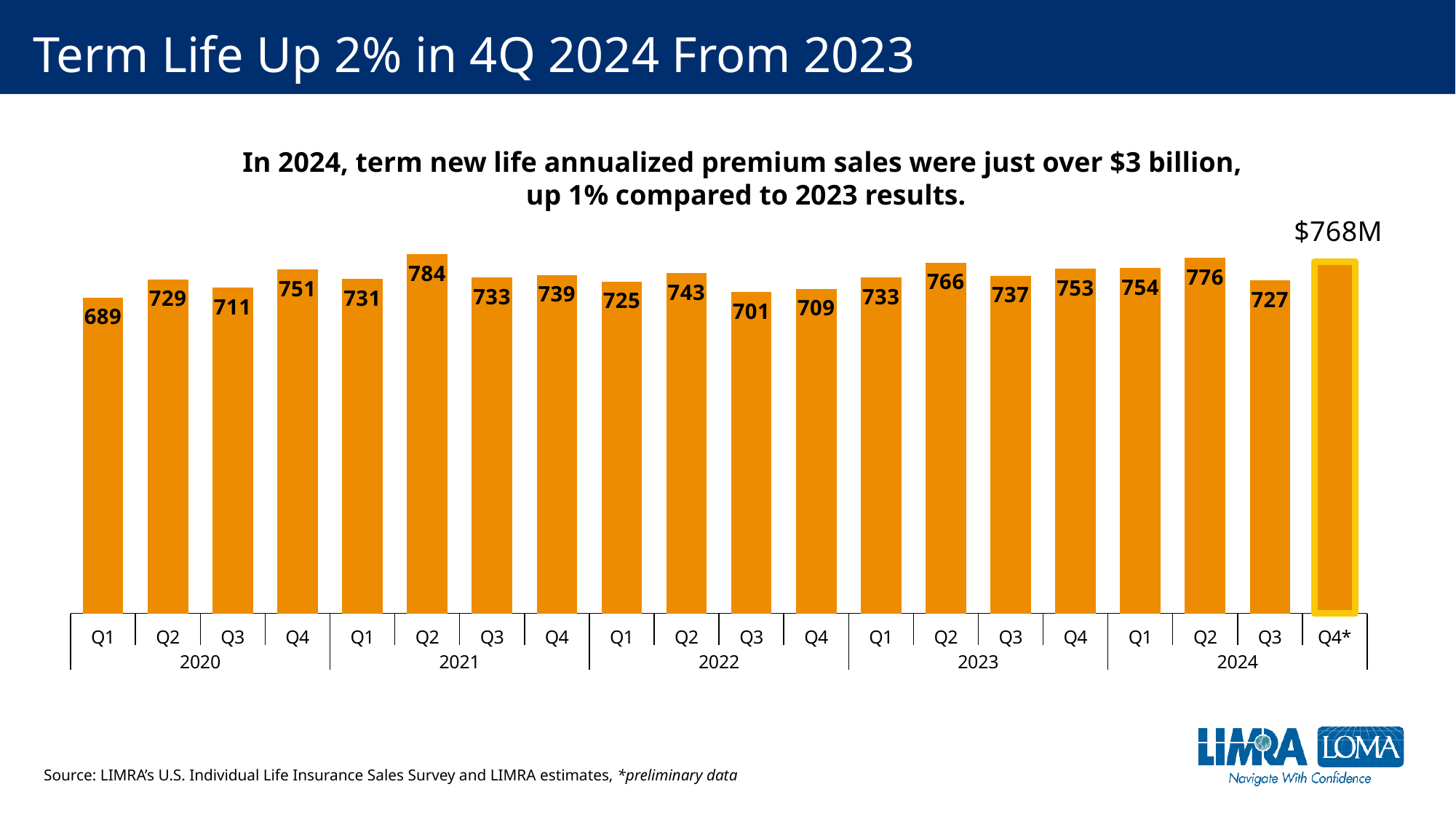
Which bar is highlighted with a yellow outline? Q4* 2024 What is the value for Q1 2020? 689 How many quarterly bars are plotted in the chart? 20 Which quarter has the lowest value? Q1 2020 What is the difference between Q4 2023 and Q4 2022? 44 Which is larger, Q2 2023 or Q1 2024? Q2 2023 What is the difference between Q2 2024 and Q3 2024? 49 What kind of chart is shown on the slide? Bar chart What is the value for Q4* 2024? $768M What is the value for Q2 2021? 784 What is the value for Q3 2022? 701 Which quarter has the highest value? Q2 2021